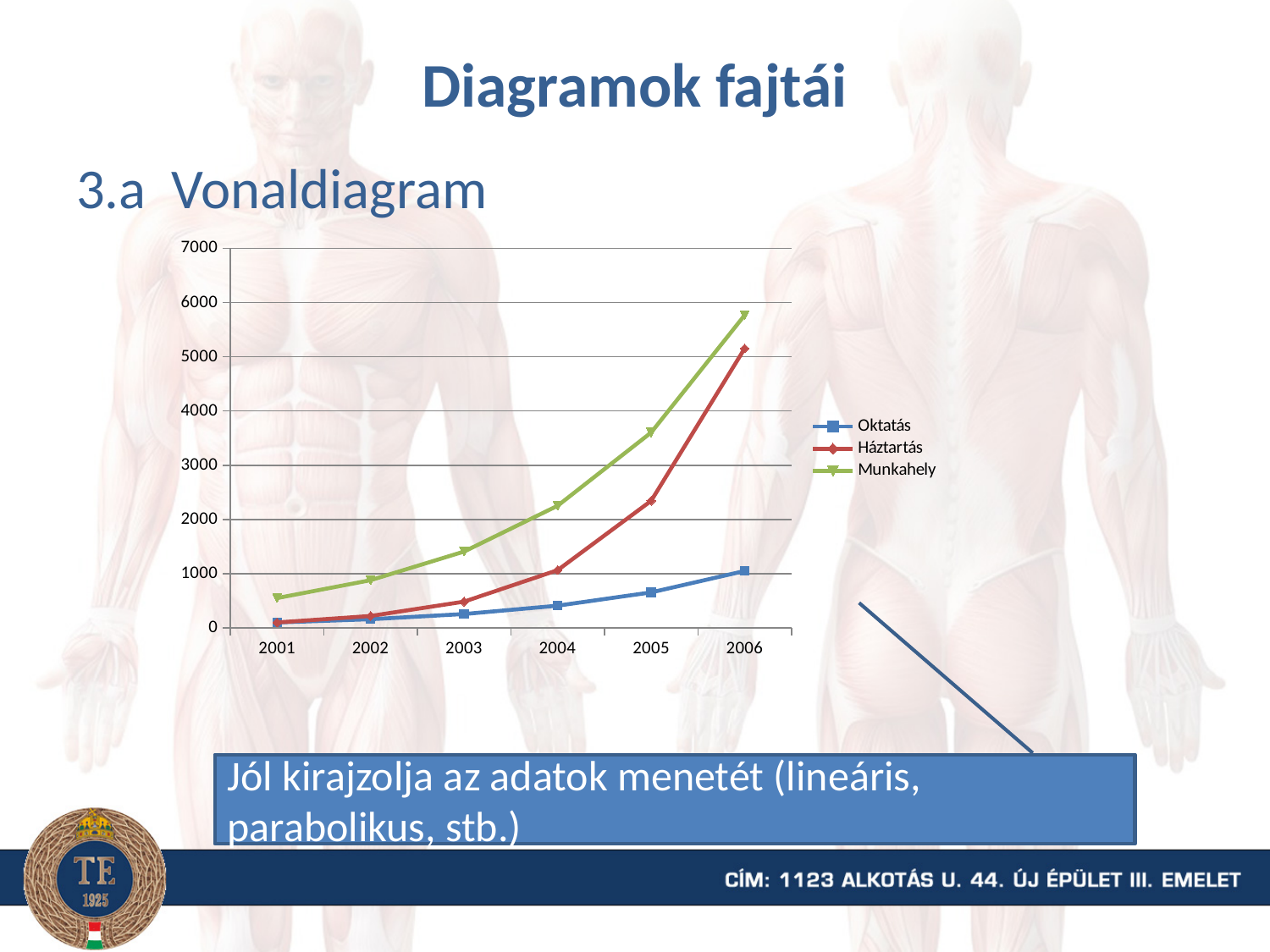
Which series has the lowest value in 2006? Oktatás Do the values of the Munkahely series rise or fall from 2001 to 2006? rise Which series is drawn in green on the chart? Munkahely Is the value for Oktatás in 2006 greater or less than 2000? less How many years are shown on the x axis of the chart? 6 How many series does the chart's legend list? 3 Is the value for Munkahely in 2006 greater or less than 5000? greater What kind of chart is shown on the slide? line chart Is the value for Munkahely in 2005 greater or less than 3000? greater Which series has the highest value in 2006? Munkahely Which is larger in 2005, the value for Háztartás or the value for Oktatás? Háztartás